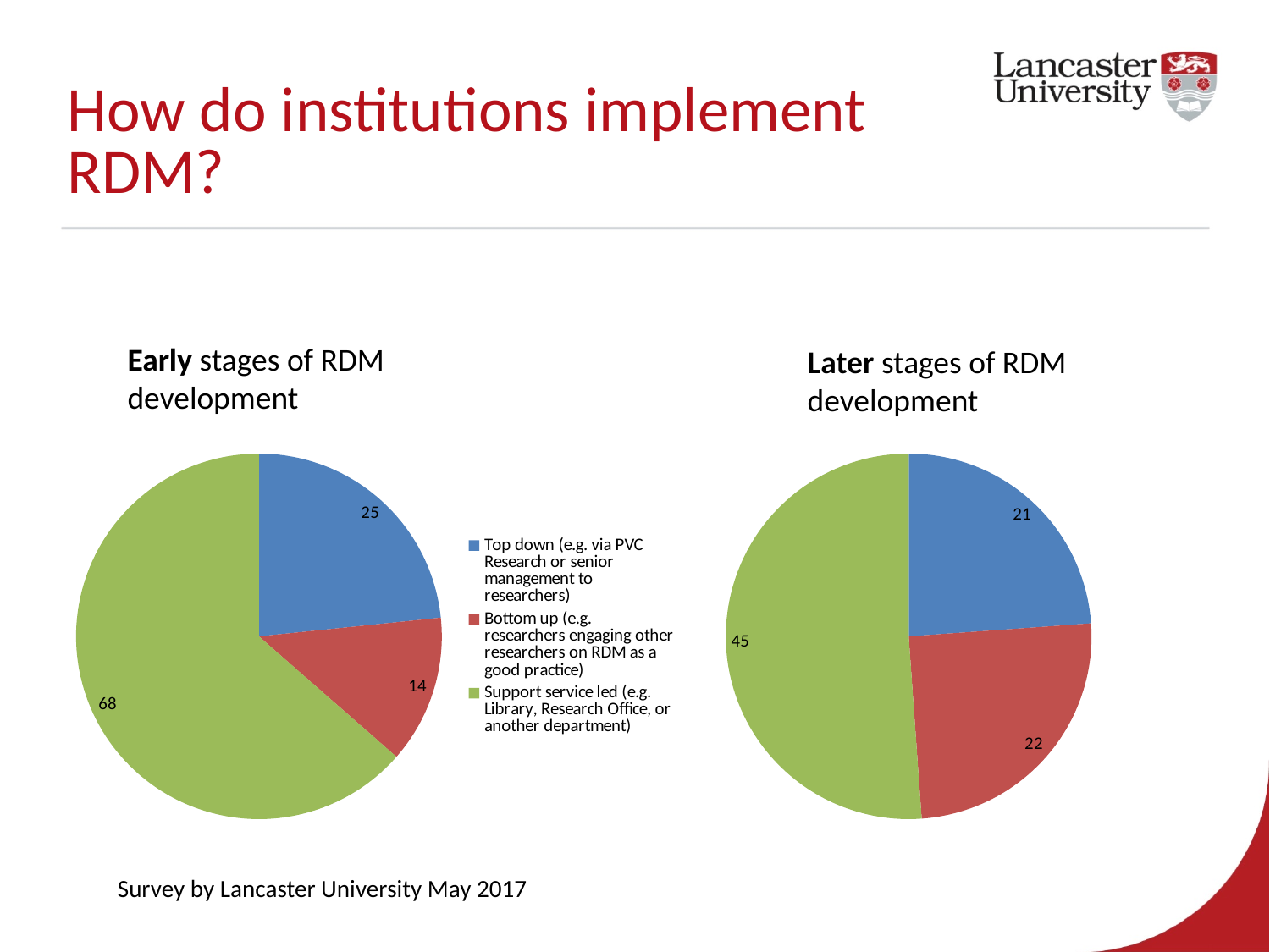
In the 'Early stages of RDM development' pie chart, what is the value for Support service led? 68 In the 'Early stages of RDM development' pie chart, which category has the largest slice? Support service led In the 'Later stages of RDM development' pie chart, what is the value for Support service led? 45 What type of chart is used for 'Early stages of RDM development'? Pie chart In the 'Later stages of RDM development' pie chart, what is the difference between the Support service led value and the Top down value? 24 In the 'Later stages of RDM development' pie chart, which category has the largest slice? Support service led Is the Top down value larger in the 'Early stages of RDM development' chart or the 'Later stages of RDM development' chart? Early stages of RDM development In the 'Early stages of RDM development' pie chart, what is the difference between the Support service led value and the Top down value? 43 In the 'Later stages of RDM development' pie chart, what is the value for Bottom up? 22 How many slices does the 'Later stages of RDM development' pie chart have? 3 In the 'Early stages of RDM development' pie chart, which category has the smallest slice? Bottom up In the 'Early stages of RDM development' pie chart, what is the value for Top down? 25